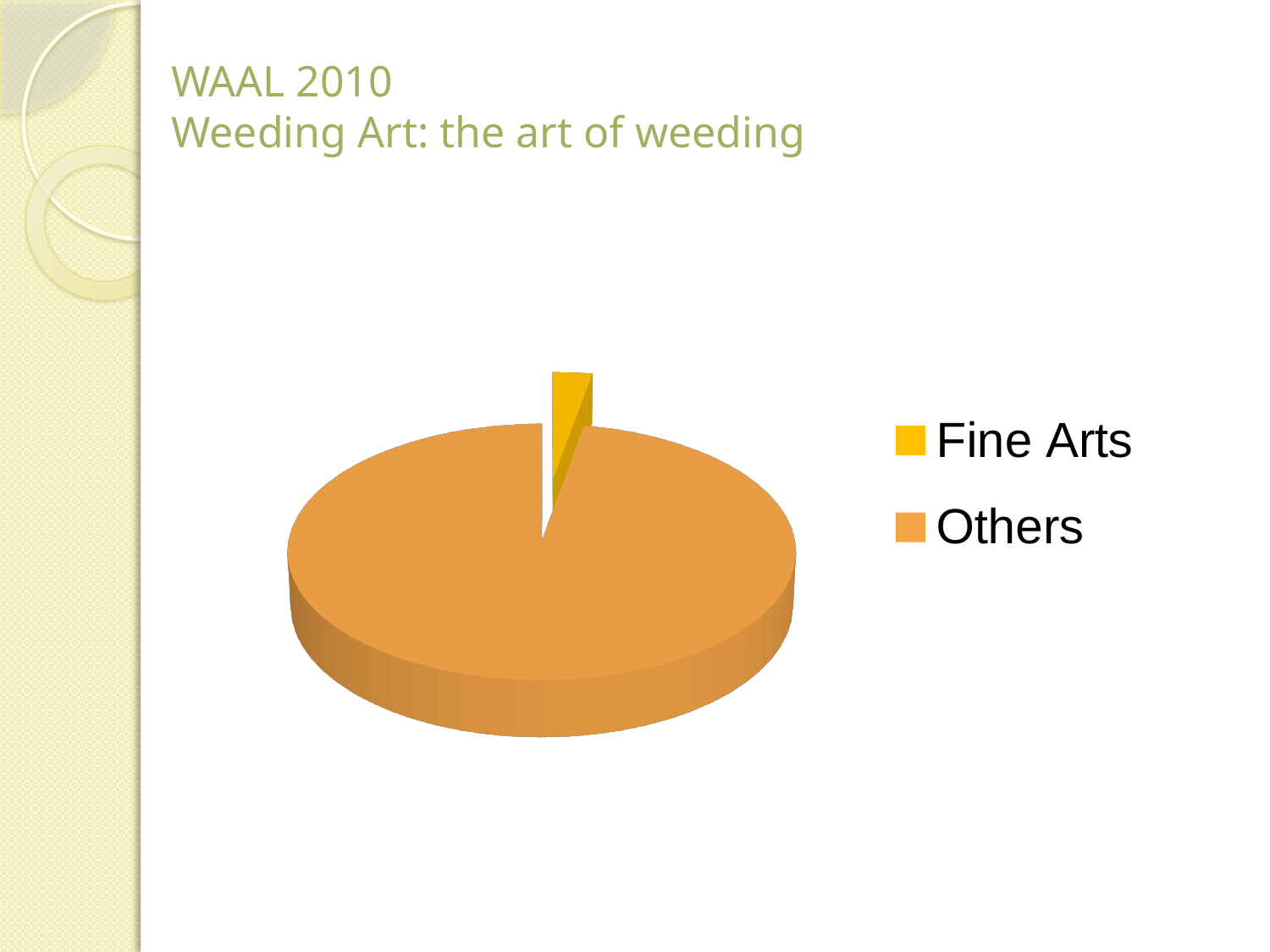
What colour is the Others slice in the pie chart? orange What colour is the Fine Arts slice in the pie chart? yellow Which slice of the pie chart is the smallest? Fine Arts Which slice of the pie chart is the largest? Others What kind of chart is shown on the slide? pie chart How many slices does the pie chart have? 2 How many entries does the legend of the pie chart list? 2 Which is larger in the pie chart, Fine Arts or Others? Others